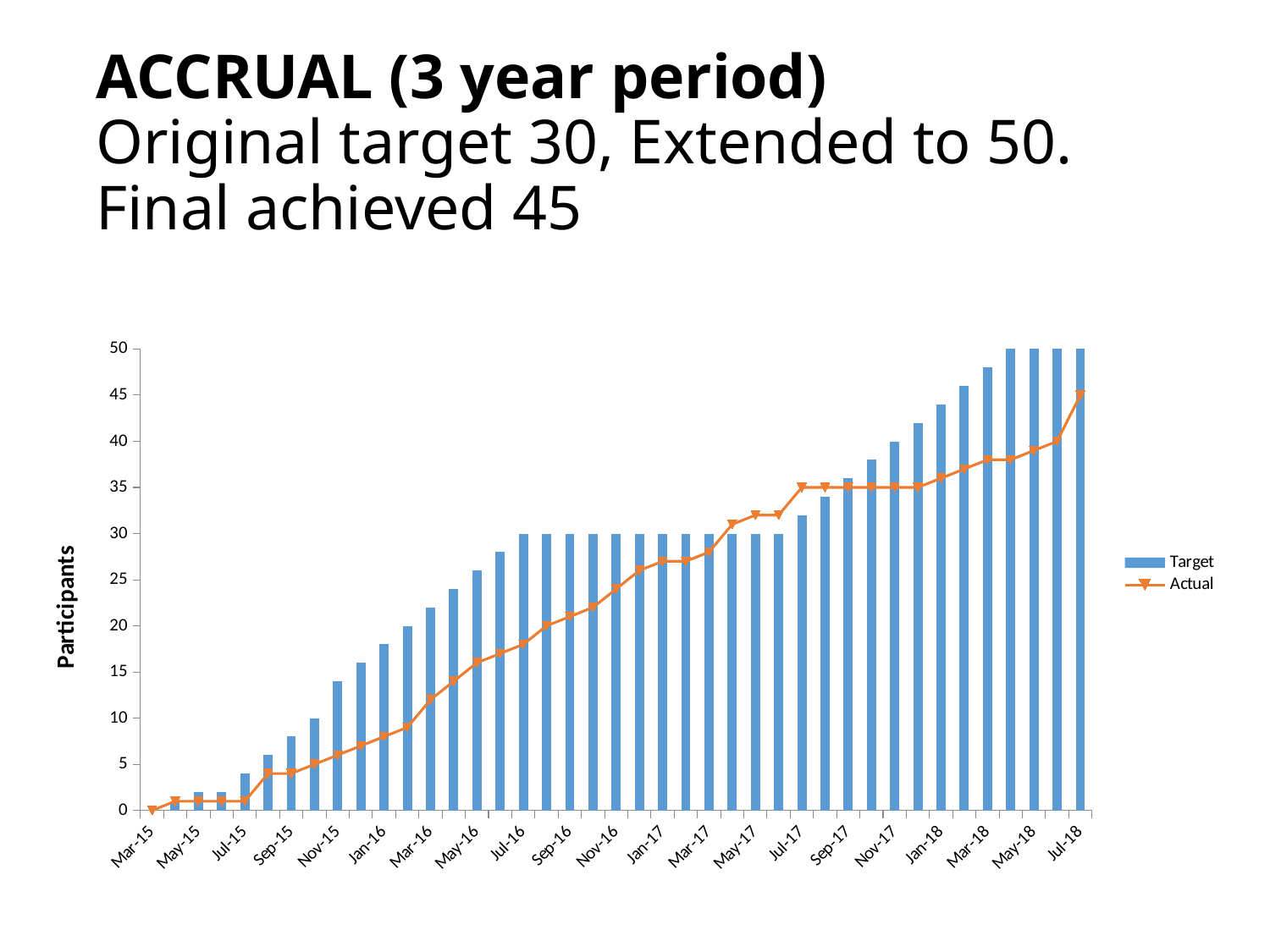
What are the two series named in the legend? Target and Actual Is the Actual value for Jan-17 greater or less than 25? greater At Jan-17, which is larger, the Target or the Actual value? Target What is the Target value for Jul-18? 50 How many series does the legend list? 2 Is the Target value for Jan-16 greater or less than 15? greater What is the label on the vertical axis? Participants What is the Target value for Jul-16? 30 What is the difference between the Target and Actual values for Jul-18? 5 What kind of chart is shown on the slide? A bar chart with a line series At which month is the Actual series at its lowest? Mar-15 What is the Actual value for Jul-18? 45